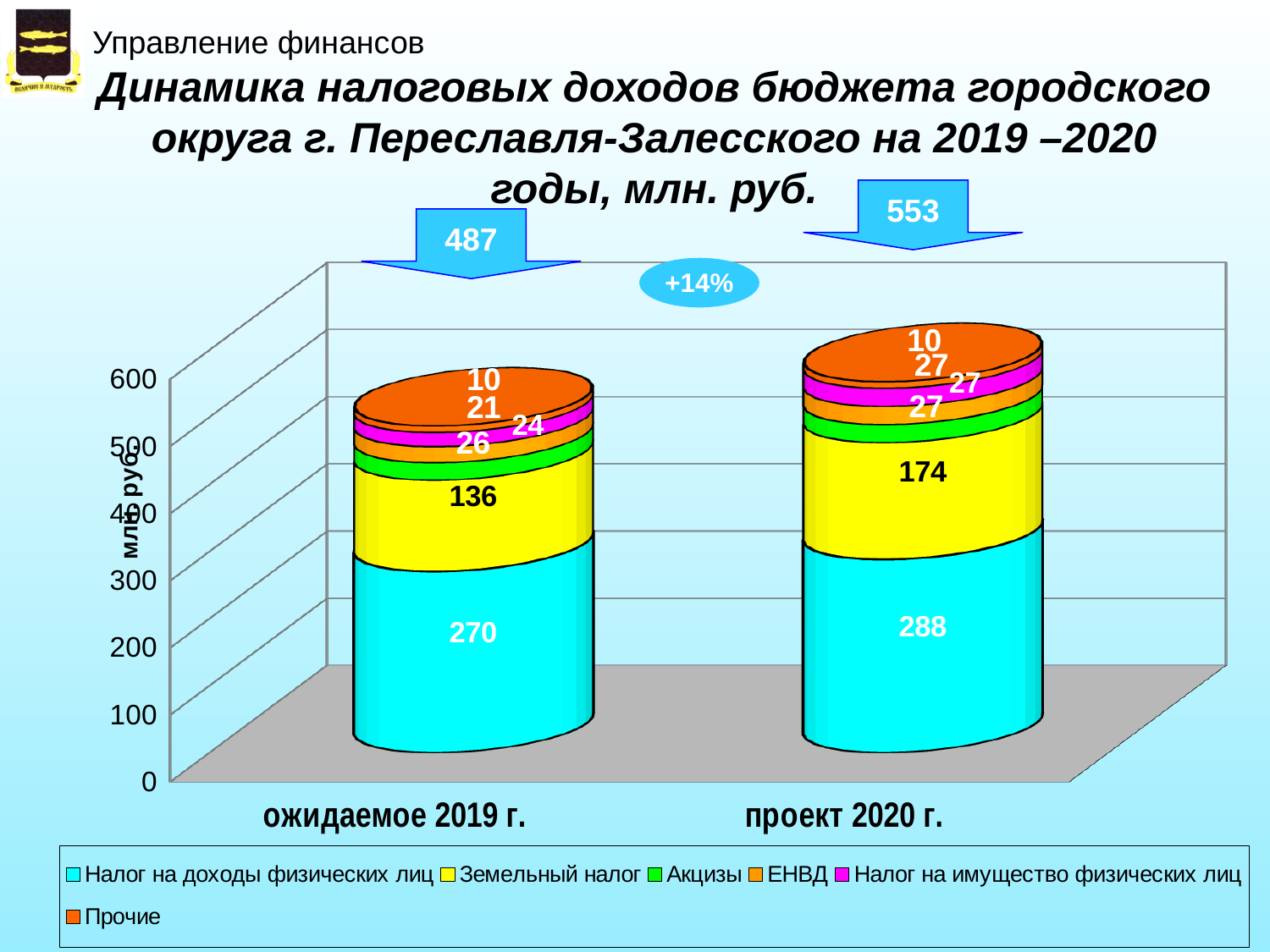
What is the total of the stacked bar for проект 2020 г.? 553 What is the total of the stacked bar for ожидаемое 2019 г.? 487 By how much does Земельный налог in проект 2020 г. exceed Земельный налог in ожидаемое 2019 г.? 38 What kind of chart is shown on the slide? Stacked bar chart What is the value of Земельный налог for ожидаемое 2019 г.? 136 How many series does the chart legend list? 6 How many categories are shown on the x axis of the chart? 2 What is the value of Налог на доходы физических лиц for ожидаемое 2019 г.? 270 Which category has the larger total: ожидаемое 2019 г. or проект 2020 г.? проект 2020 г. What is the value of Налог на доходы физических лиц for проект 2020 г.? 288 What is the value of Земельный налог for проект 2020 г.? 174 What percentage change between the two years is shown on the chart? +14%